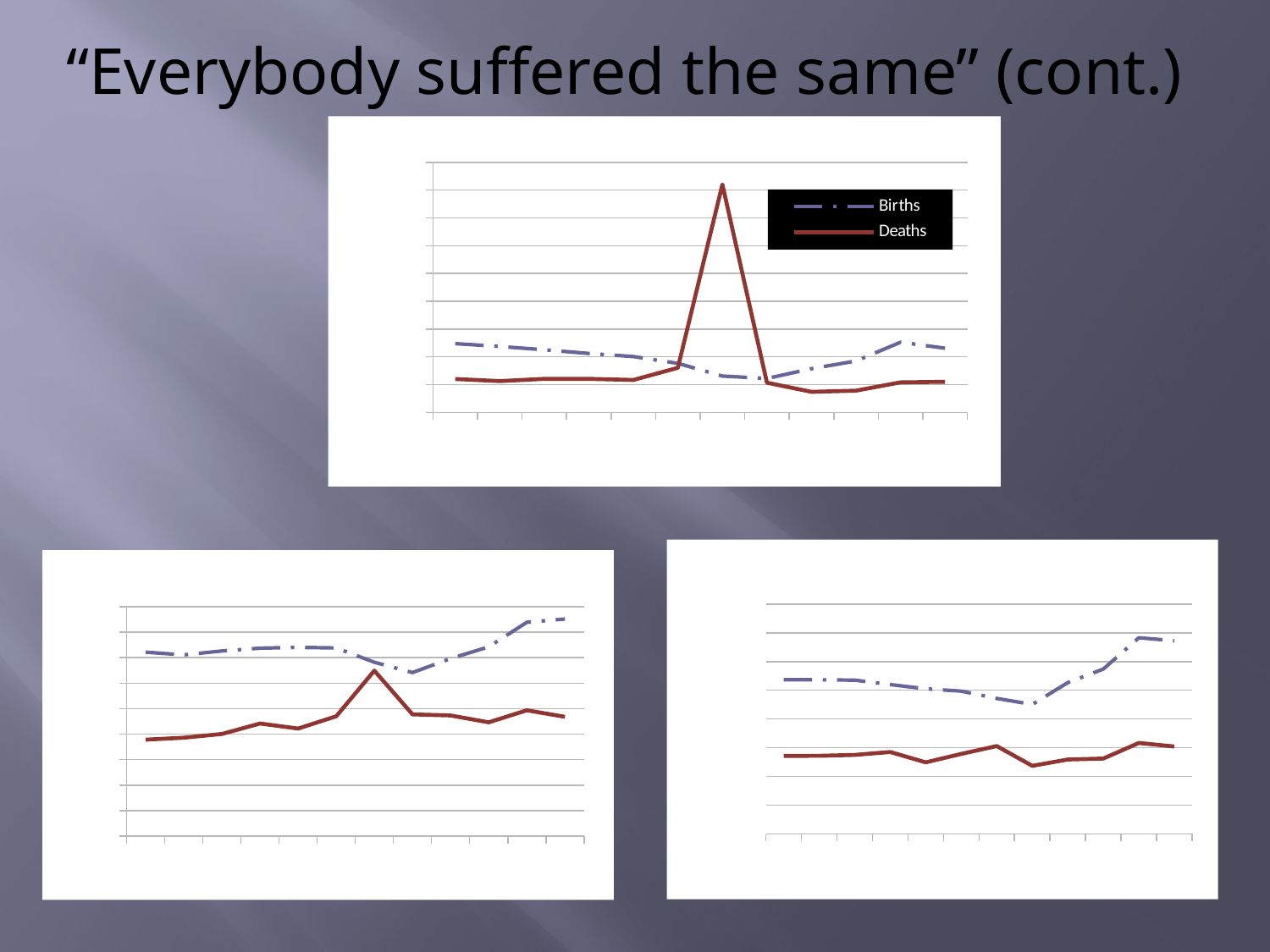
How many series does the legend of the top chart list? 2 In the bottom-right chart, is the dashed line above or below the solid line across the whole x axis? above In the bottom-left chart, is the dashed line higher at its last point than at its first point? yes In the bottom-right chart, does the dashed line rise or fall over its last few points? rises What kind of chart is the bottom-left chart on the slide? line chart In the top chart, at the tall spike, which series has the higher value, Births or Deaths? Deaths In the top chart, which series has the tall spike near the middle of the x axis? Deaths In the top chart, which series is drawn with a dashed line? Births What are the two series named in the legend of the top chart? Births and Deaths What kind of chart is the top chart on the slide? line chart